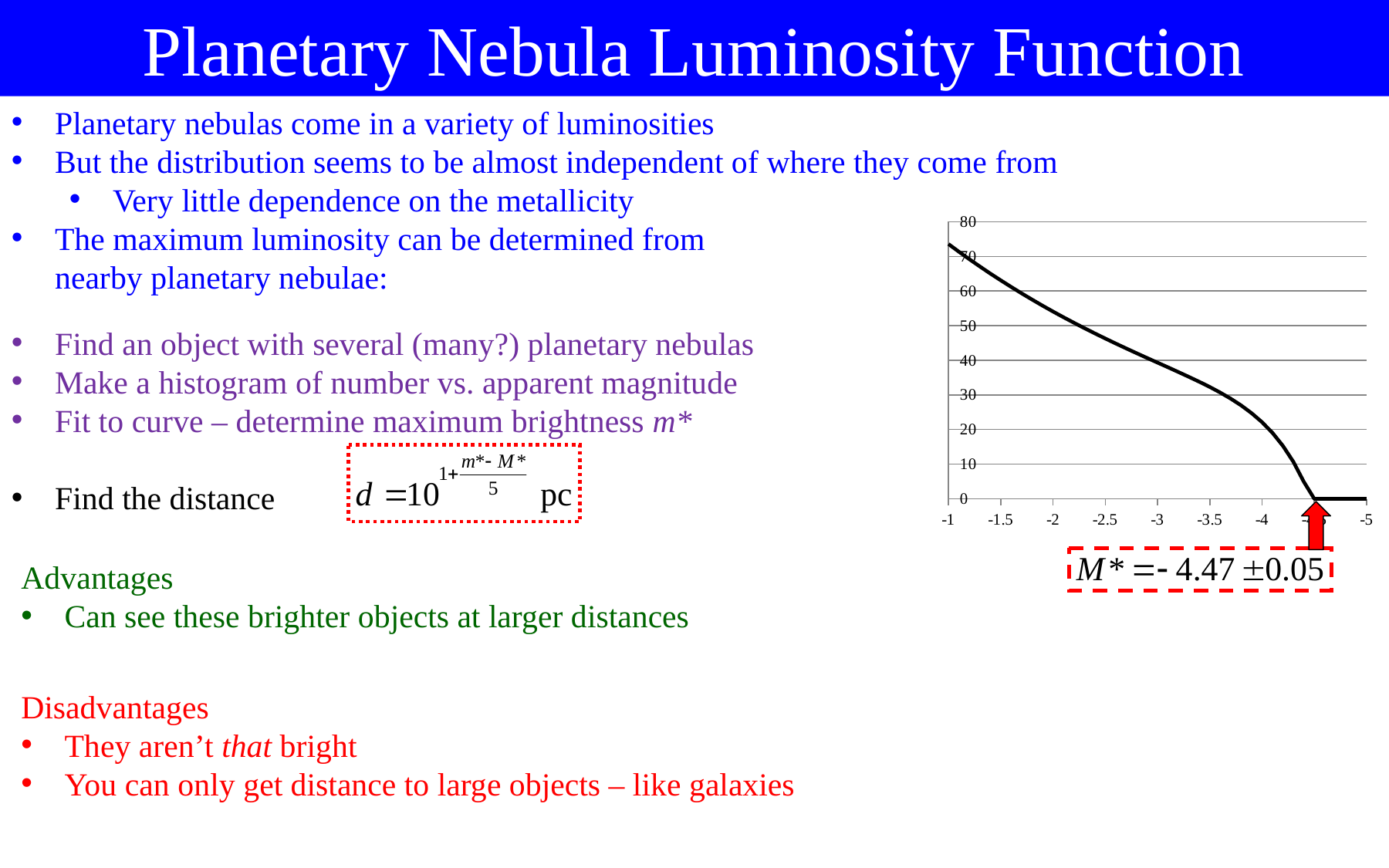
Is the value of the curve at x = -5 greater or less than 10? less How many tick labels are shown on the x axis of the chart? 9 What value of M* is annotated below the chart? -4.47 ± 0.05 At which x-axis tick does the curve reach its highest value? -1 Does the plotted curve rise or fall as you move from left to right along the x axis? fall Is the value of the curve at x = -3.5 greater or less than 40? less What kind of chart is shown on the right side of the slide? line chart Is the value of the curve at x = -1 greater or less than 60? greater Which is larger, the value of the curve at x = -1 or at x = -4? x = -1 How many lines are plotted on the chart? 1 What is the highest value labelled on the y axis of the chart? 80